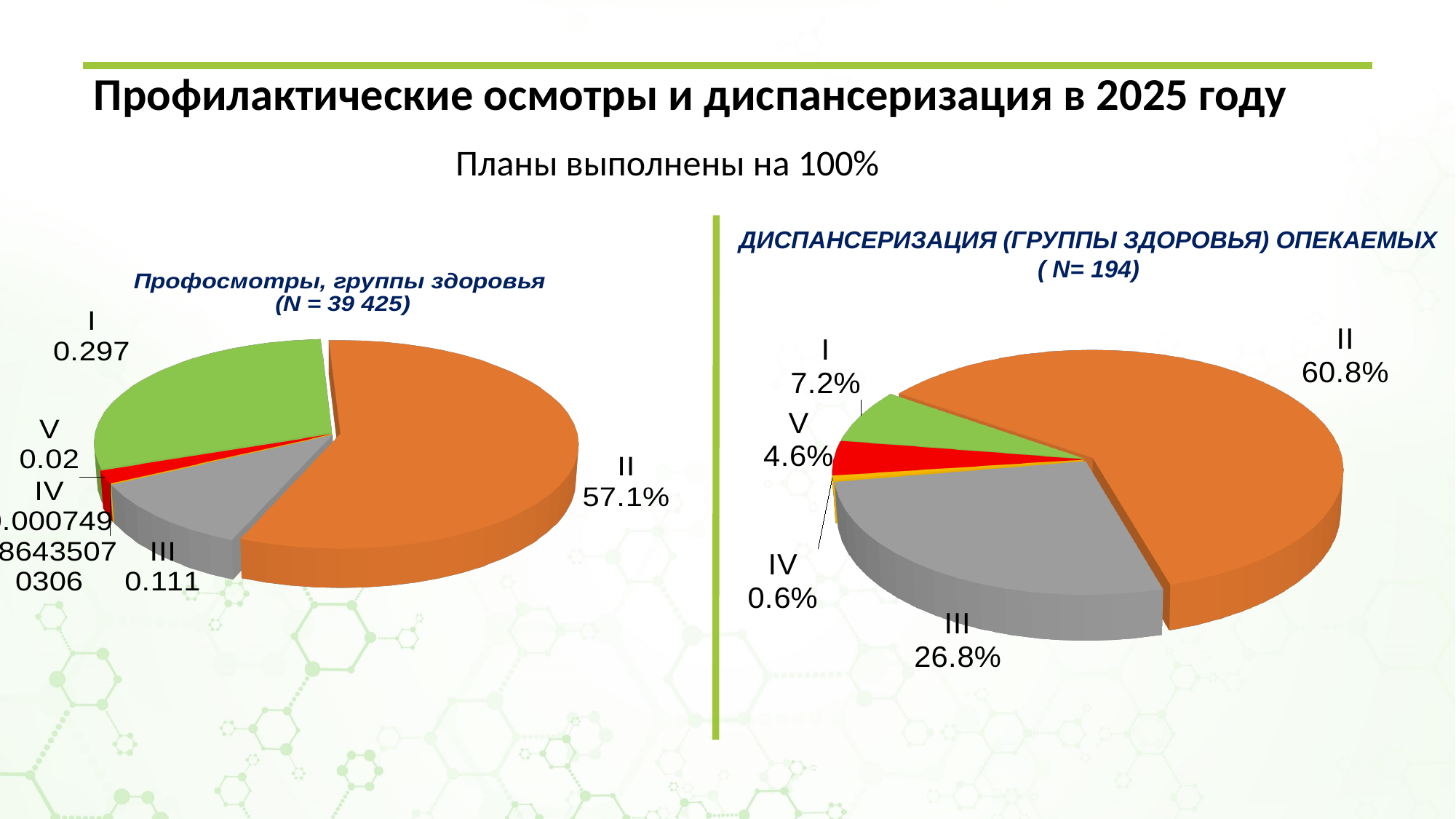
In the left chart (Профосмотры, группы здоровья), what is the value for group III? 0.111 In the right chart (ДИСПАНСЕРИЗАЦИЯ (ГРУППЫ ЗДОРОВЬЯ) ОПЕКАЕМЫХ), what is the value for group III? 26.8% In the right chart (ДИСПАНСЕРИЗАЦИЯ (ГРУППЫ ЗДОРОВЬЯ) ОПЕКАЕМЫХ), which group has the smallest share? IV What kind of chart is used on the right side of the slide (ДИСПАНСЕРИЗАЦИЯ (ГРУППЫ ЗДОРОВЬЯ) ОПЕКАЕМЫХ)? Pie chart In the right chart (ДИСПАНСЕРИЗАЦИЯ (ГРУППЫ ЗДОРОВЬЯ) ОПЕКАЕМЫХ), what is the value for group II? 60.8% In the right chart (ДИСПАНСЕРИЗАЦИЯ (ГРУППЫ ЗДОРОВЬЯ) ОПЕКАЕМЫХ), what is the value for group IV? 0.6% In the right chart (ДИСПАНСЕРИЗАЦИЯ (ГРУППЫ ЗДОРОВЬЯ) ОПЕКАЕМЫХ), what is the difference between the values for group II and group III? 34.0% In the left chart (Профосмотры, группы здоровья), what is the value for group I? 0.297 In the right chart (ДИСПАНСЕРИЗАЦИЯ (ГРУППЫ ЗДОРОВЬЯ) ОПЕКАЕМЫХ), which is larger, group I or group V? I In the right chart (ДИСПАНСЕРИЗАЦИЯ (ГРУППЫ ЗДОРОВЬЯ) ОПЕКАЕМЫХ), which group has the largest share? II In the left chart (Профосмотры, группы здоровья), which group has the largest share? II In the left chart (Профосмотры, группы здоровья), what is the value for group II? 57.1%